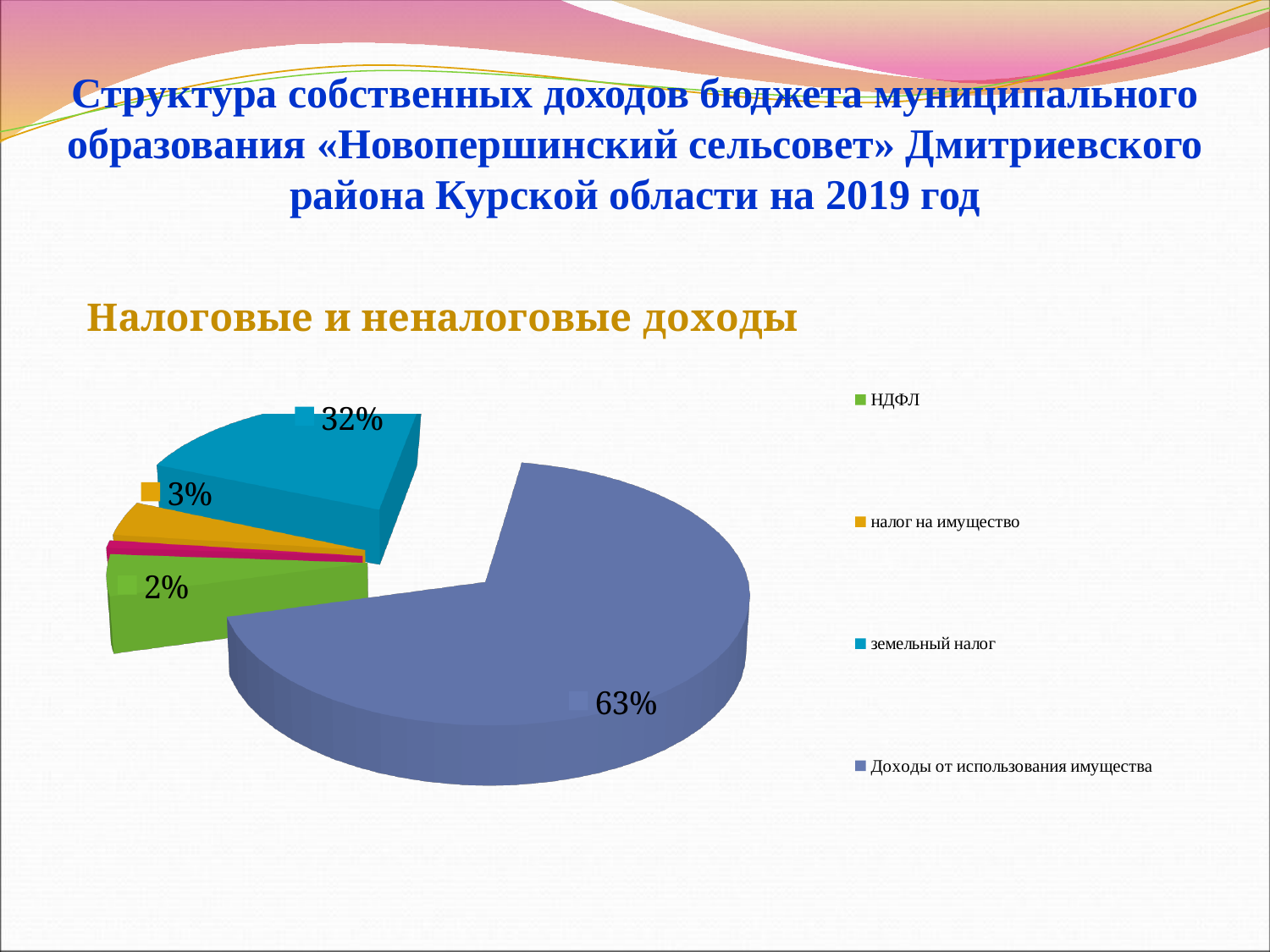
How many entries does the legend list? 4 What colour is the slice for земельный налог? cyan (light blue) What share of the pie does Доходы от использования имущества have? 63% What share of the pie does НДФЛ have? 2% Which category has the largest share of the pie? Доходы от использования имущества What is the difference in percentage points between Доходы от использования имущества and земельный налог? 31 What is the title of the chart? Налоговые и неналоговые доходы Which is larger, the share for земельный налог or the share for налог на имущество? земельный налог What share of the pie does земельный налог have? 32% What kind of chart is shown on the slide? pie chart What share of the pie does налог на имущество have? 3%